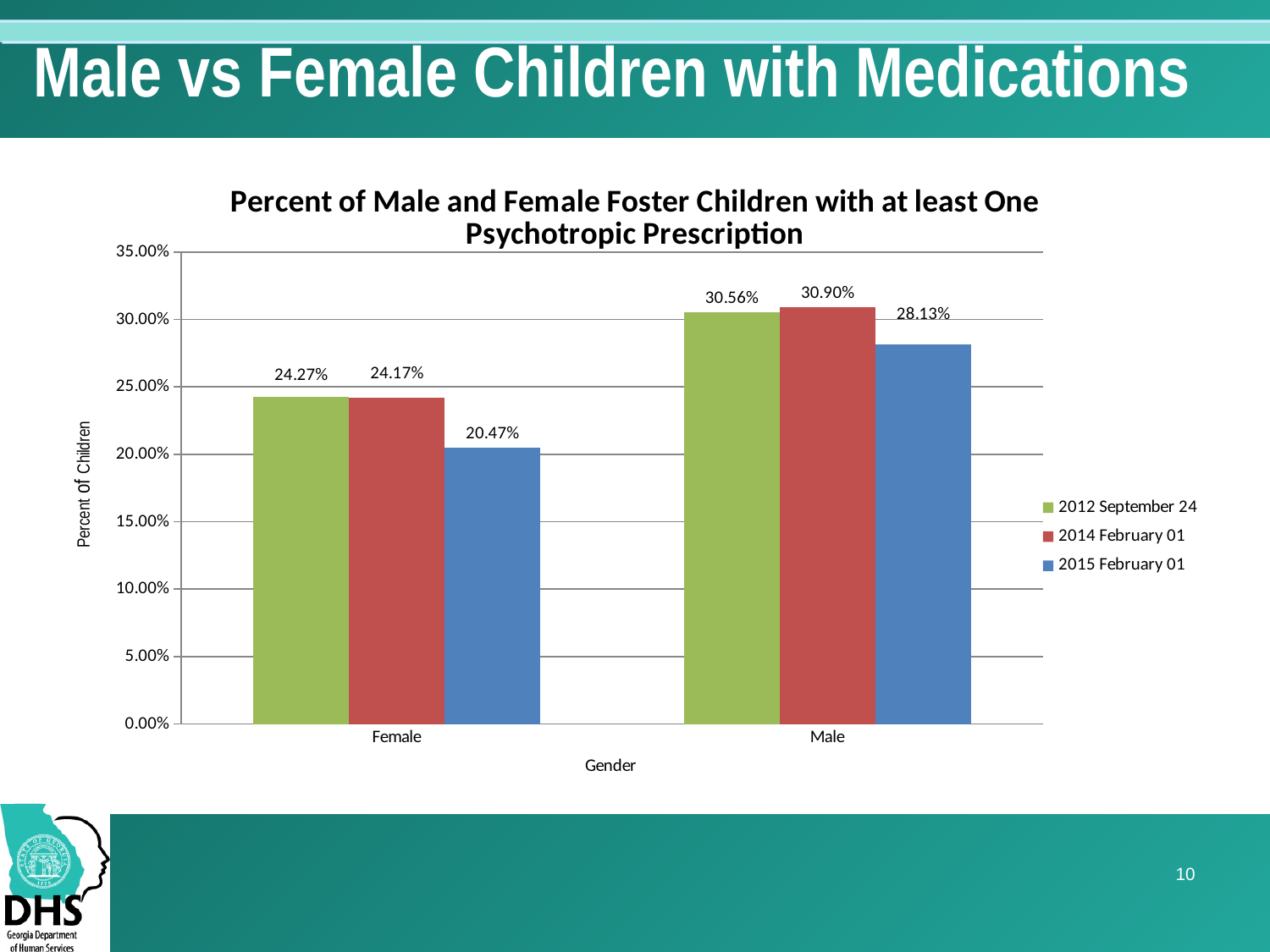
Which gender has the lowest value in the 2015 February 01 series? Female Which gender has the highest value in the 2012 September 24 series? Male What is the value for Male in the 2015 February 01 series? 28.13% What kind of chart is shown on the slide? Bar chart What is the value for Female in the 2012 September 24 series? 24.27% What is the difference between the Male and Female values in the 2015 February 01 series? 7.66% What is the value for Male in the 2014 February 01 series? 30.90% What is the value for Female in the 2015 February 01 series? 20.47% How many series does the legend list? 3 What is the label of the y axis? Percent Of Children How many gender categories are shown on the x axis? 2 Which is larger for Male: the 2014 February 01 value or the 2015 February 01 value? 2014 February 01